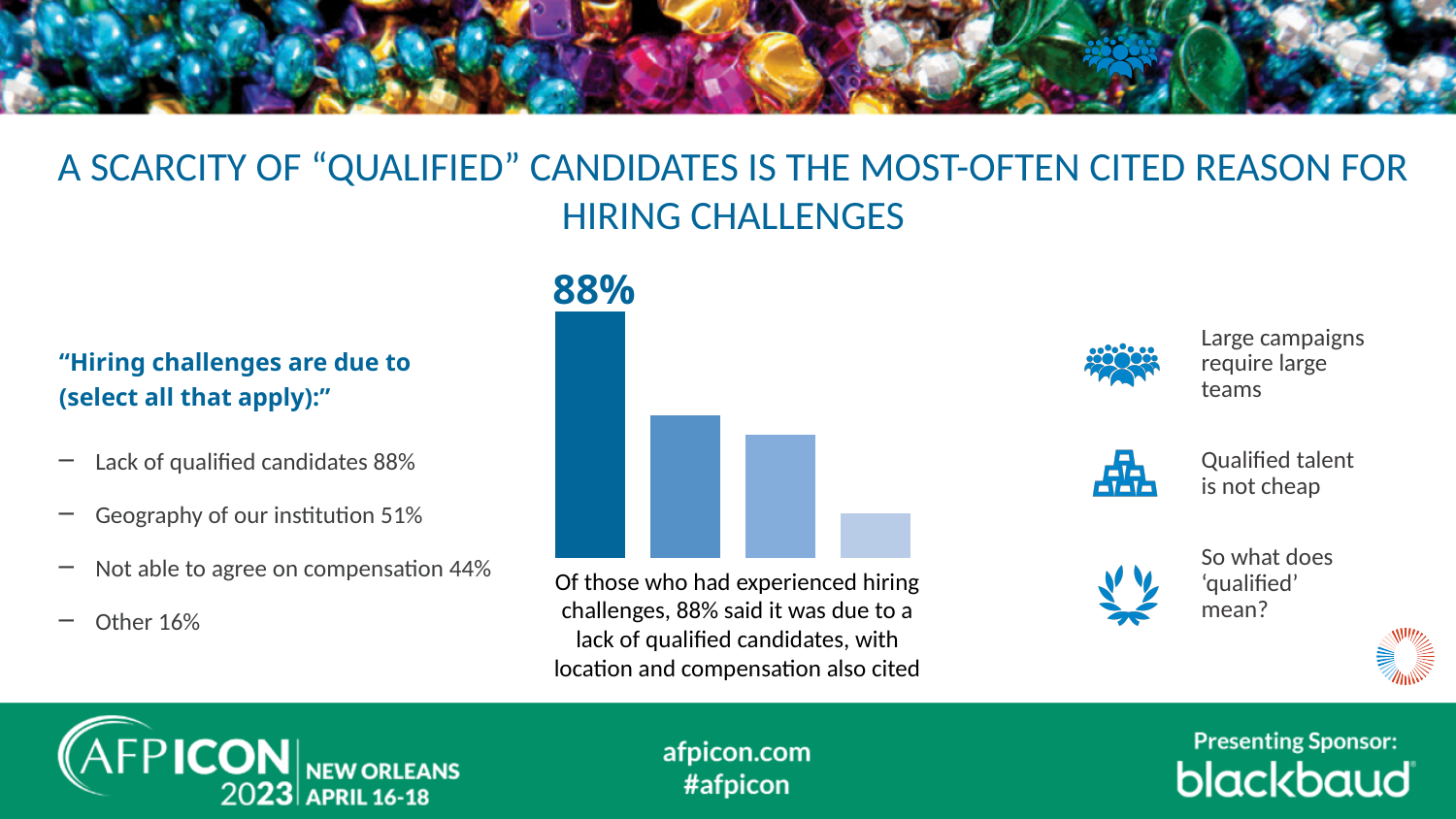
Is the first bar taller or shorter than the fourth bar? taller Is the second bar taller or shorter than the third bar? taller Which bar in the chart is the shortest? the fourth (rightmost) bar According to the text below the chart, what did 88% of respondents say their hiring challenges were due to? a lack of qualified candidates Which bar in the chart is the tallest? the first (leftmost) bar What type of chart is shown on the slide? bar chart What colour is the tallest bar in the chart? dark blue What value is printed above the tallest bar in the chart? 88% Do the bar heights rise or fall from left to right across the chart? fall How many bars does the chart contain? 4